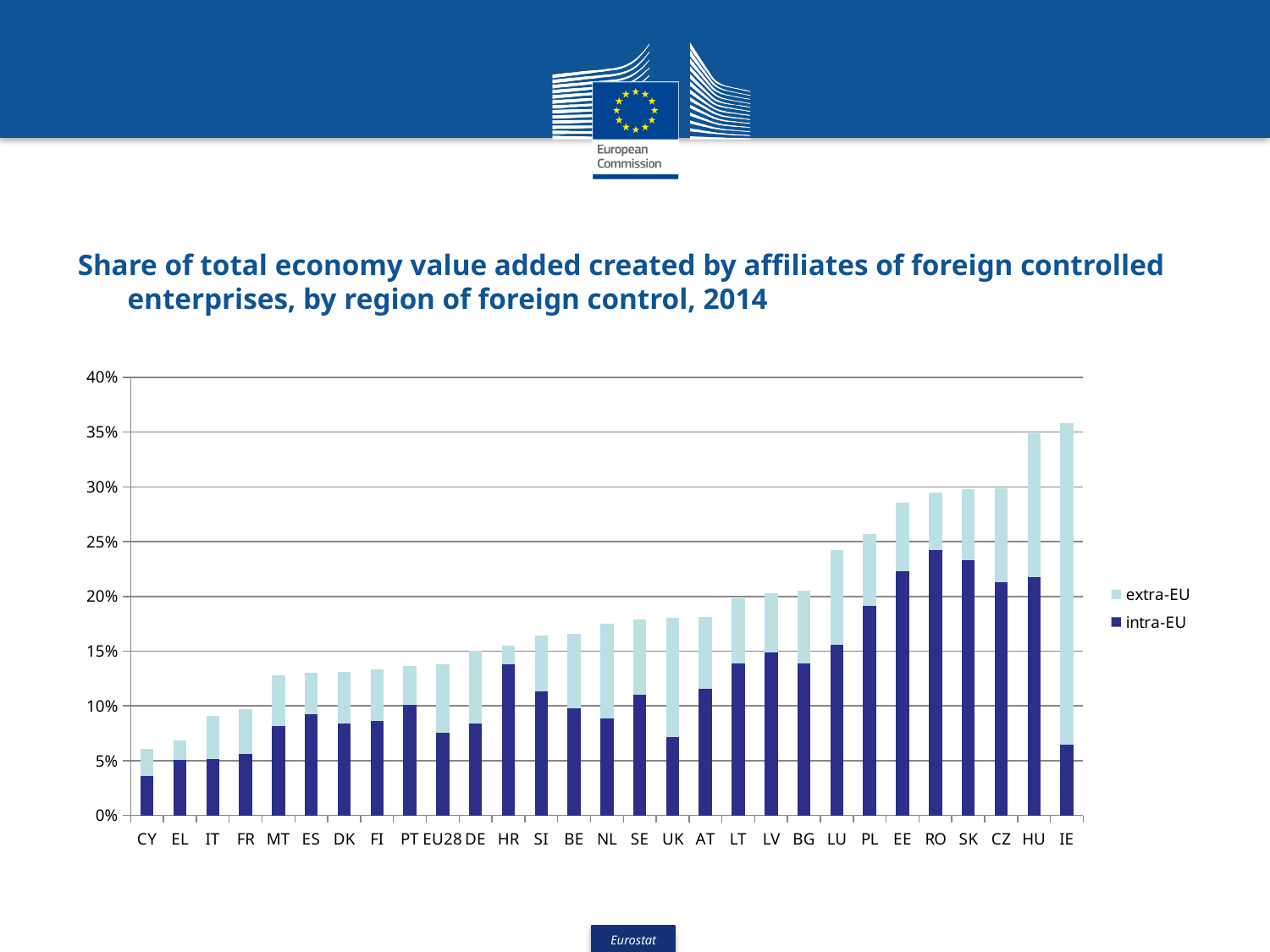
Which has the larger intra-EU share, RO or IE? RO Which country has the largest intra-EU share? RO Is the intra-EU value for RO greater or less than 20%? greater Is the total value for HU greater or less than 30%? greater How many countries/regions are shown on the x axis? 29 Is the intra-EU value for IE greater or less than 10%? less Which country has the lowest total share of value added created by foreign controlled affiliates? CY How many series does the legend list? 2 What kind of chart is shown on the slide? stacked bar chart Which country has the highest total share of value added created by foreign controlled affiliates? IE Do the total bar heights generally rise or fall from left to right along the x axis? rise